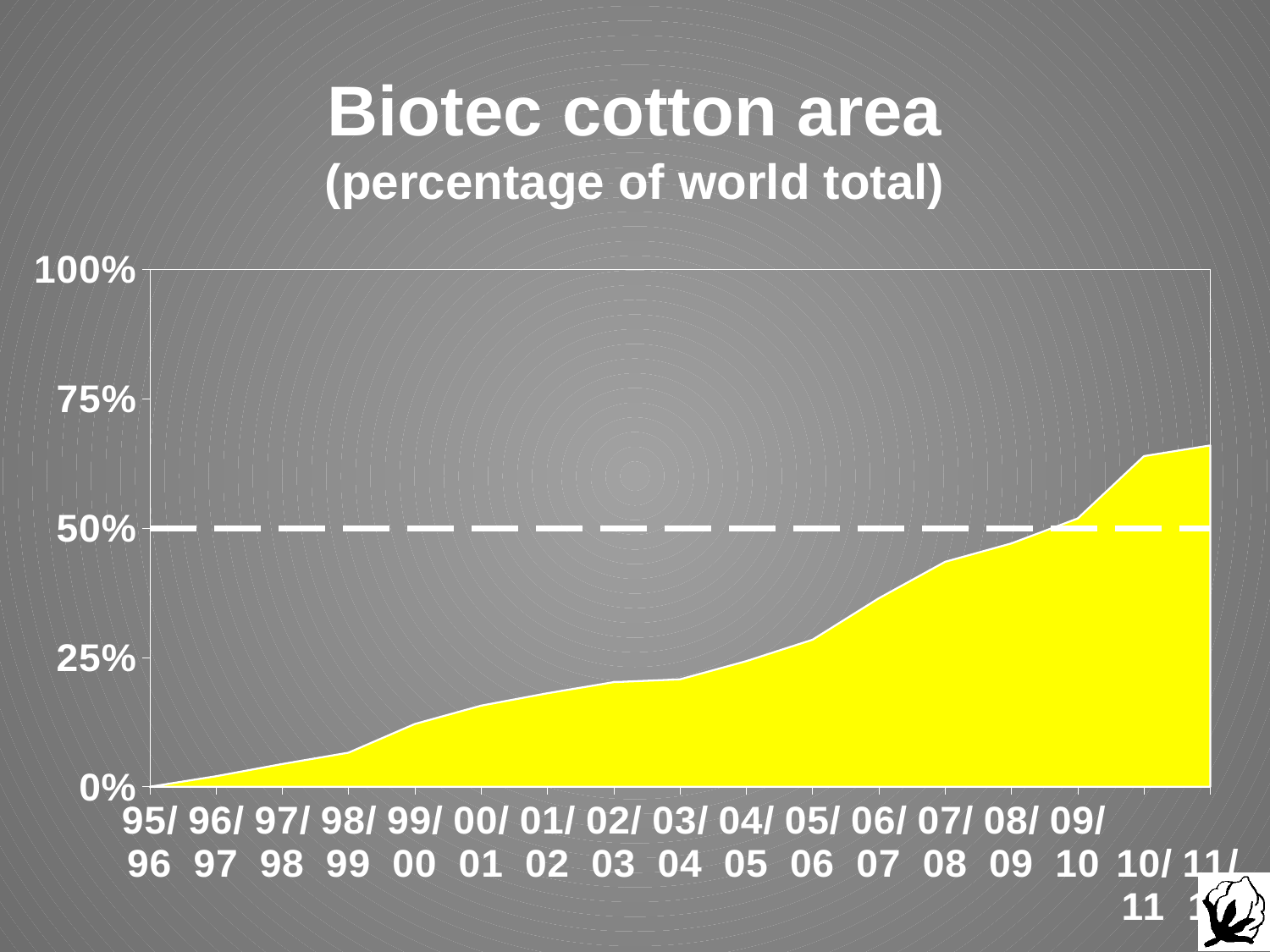
Is the value for 07/08 greater or less than 50%? less What is the title of the chart? Biotec cotton area (percentage of world total) Which season has the highest biotech cotton share? 11/12 Is the value for 06/07 greater or less than 25%? greater How many seasons are shown along the x axis? 17 Which season has the lowest biotech cotton share? 95/96 Is the value for 10/11 greater or less than 50%? greater What kind of chart is shown on the slide? area chart Does the biotech cotton share rise or fall from 95/96 to 11/12? rise At what percentage level is the horizontal dashed line drawn? 50% Which season has the larger biotech cotton share, 99/00 or 05/06? 05/06